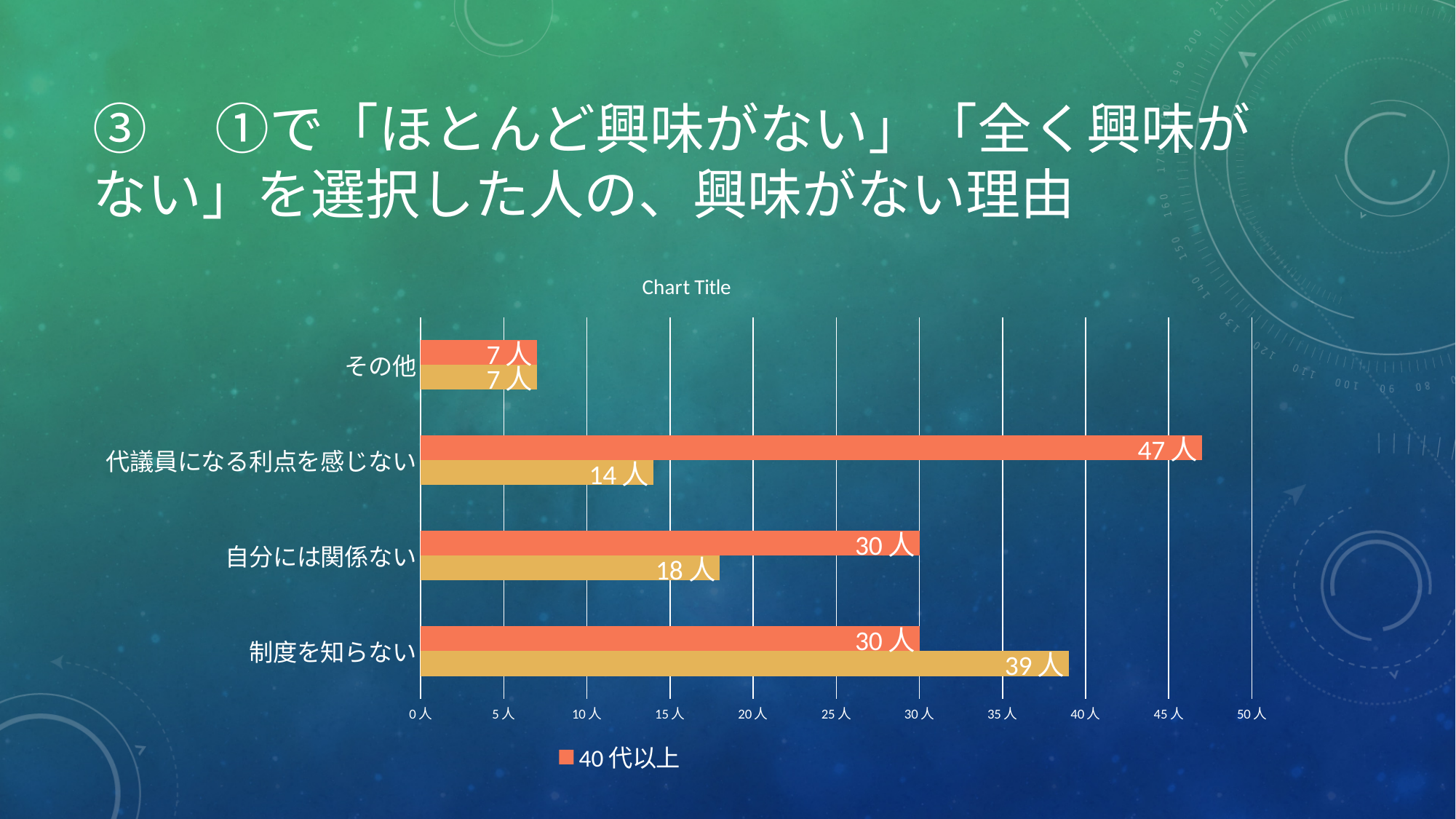
What is the value for 代議員になる利点を感じない in the 40代以上 series? 47人 What is the value of the yellow bar for 自分には関係ない? 18人 What is the value of the yellow bar for 制度を知らない? 39人 What kind of chart is shown on the slide? bar chart What is the title shown above the chart? Chart Title What is the value for 自分には関係ない in the 40代以上 series? 30人 For 制度を知らない, which is larger: the 40代以上 bar or the yellow bar? the yellow bar How many categories are shown on the chart? 4 How many series does the legend list? 1 Which category has the highest value in the 40代以上 series? 代議員になる利点を感じない Which category has the lowest value among the yellow bars? その他 What is the difference between the 40代以上 value and the yellow bar value for 代議員になる利点を感じない? 33人